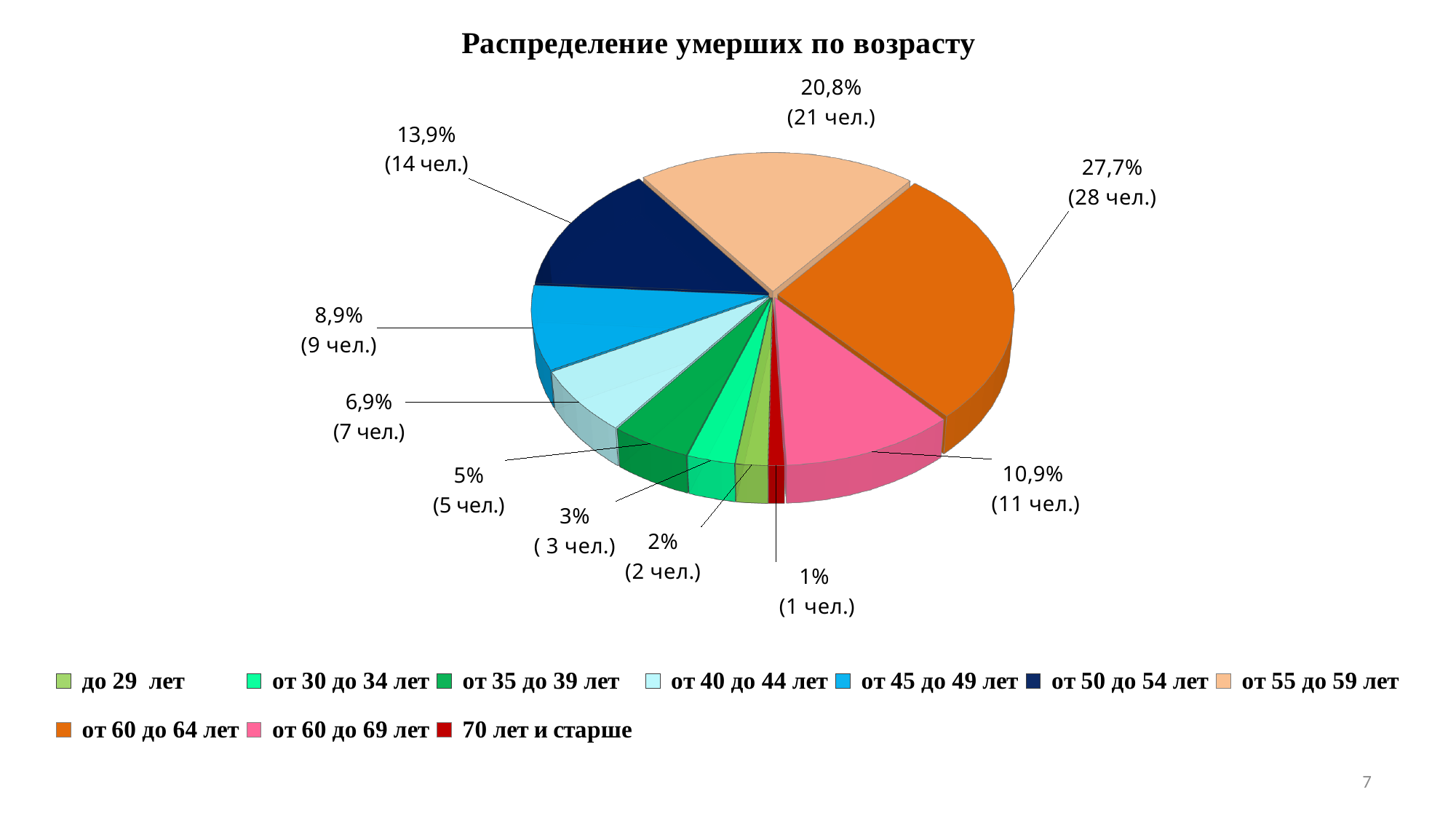
What is the difference in number of people between the 'от 60 до 64 лет' and 'от 55 до 59 лет' categories? 7 чел. How many categories does the legend list? 10 How many people are in the 'от 45 до 49 лет' category? 9 чел. Which age category has the largest slice? от 60 до 64 лет What is the title of the chart? Распределение умерших по возрасту Which age category has the smallest slice? 70 лет и старше What percentage is shown for the 'от 50 до 54 лет' slice? 13,9% What percentage is shown for the 'до 29 лет' slice? 2% How many people are in the 'от 55 до 59 лет' category? 21 чел. Which is larger: the 'от 60 до 69 лет' slice or the 'от 40 до 44 лет' slice? от 60 до 69 лет What type of chart is shown on the slide? pie chart What share of the pie does the 'от 60 до 64 лет' slice have? 27,7%